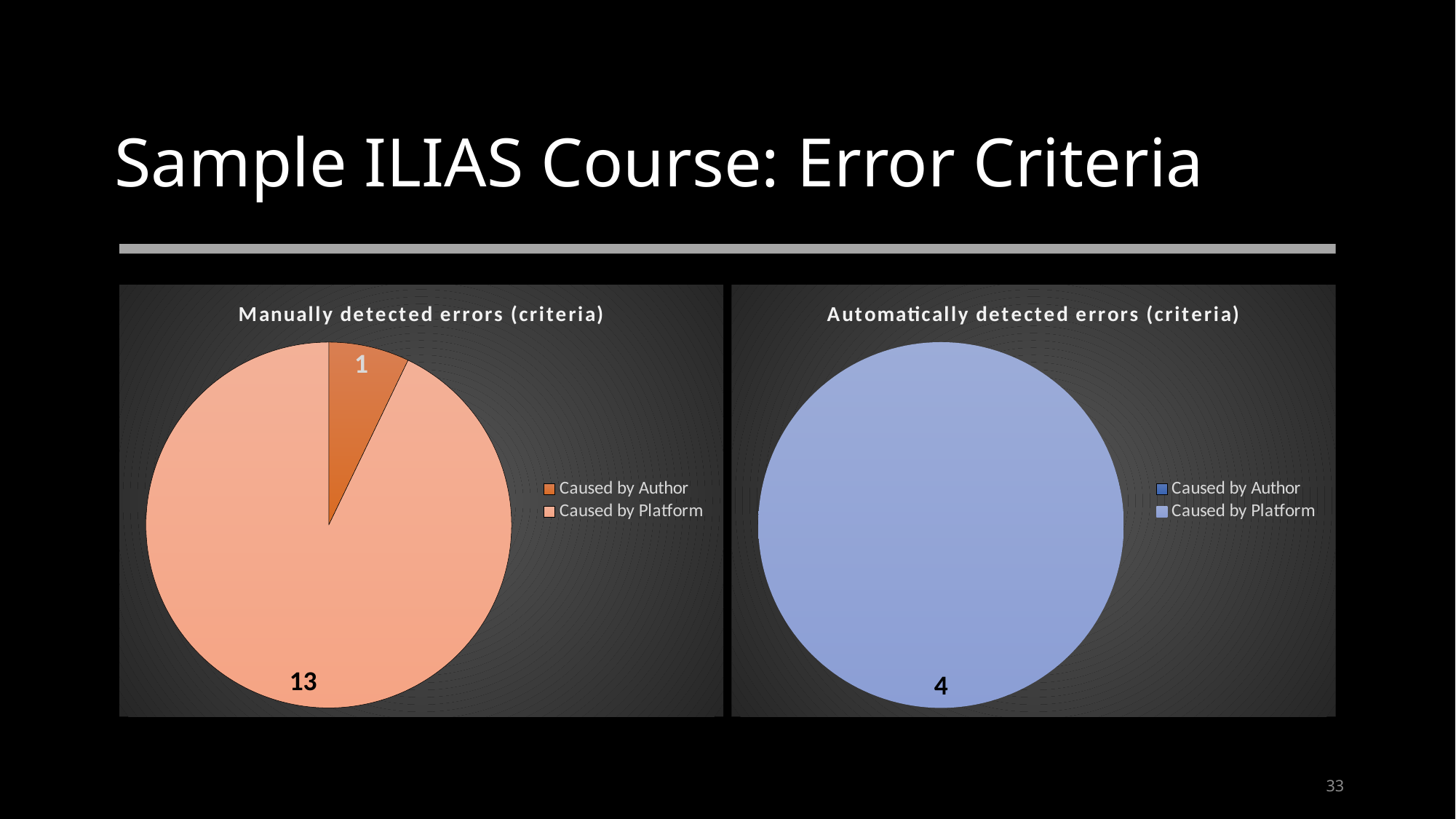
In the 'Manually detected errors (criteria)' chart, what is the value for Caused by Author? 1 What type of chart is the 'Automatically detected errors (criteria)' chart? Pie chart In the 'Automatically detected errors (criteria)' chart, what value is printed on the Caused by Platform slice? 4 In the 'Manually detected errors (criteria)' chart, which category has the smallest slice? Caused by Author What type of chart is the 'Manually detected errors (criteria)' chart? Pie chart In the 'Manually detected errors (criteria)' chart, which category has the largest slice? Caused by Platform In the 'Manually detected errors (criteria)' chart, which is larger: Caused by Author or Caused by Platform? Caused by Platform In the 'Manually detected errors (criteria)' chart, what is the difference between the Caused by Platform and Caused by Author values? 12 In the 'Manually detected errors (criteria)' chart, what colour is the Caused by Author slice? Orange What is the title of the chart on the left side of the slide? Manually detected errors (criteria) In the 'Manually detected errors (criteria)' chart, what is the value for Caused by Platform? 13 How many entries does the legend of the 'Automatically detected errors (criteria)' chart list? 2